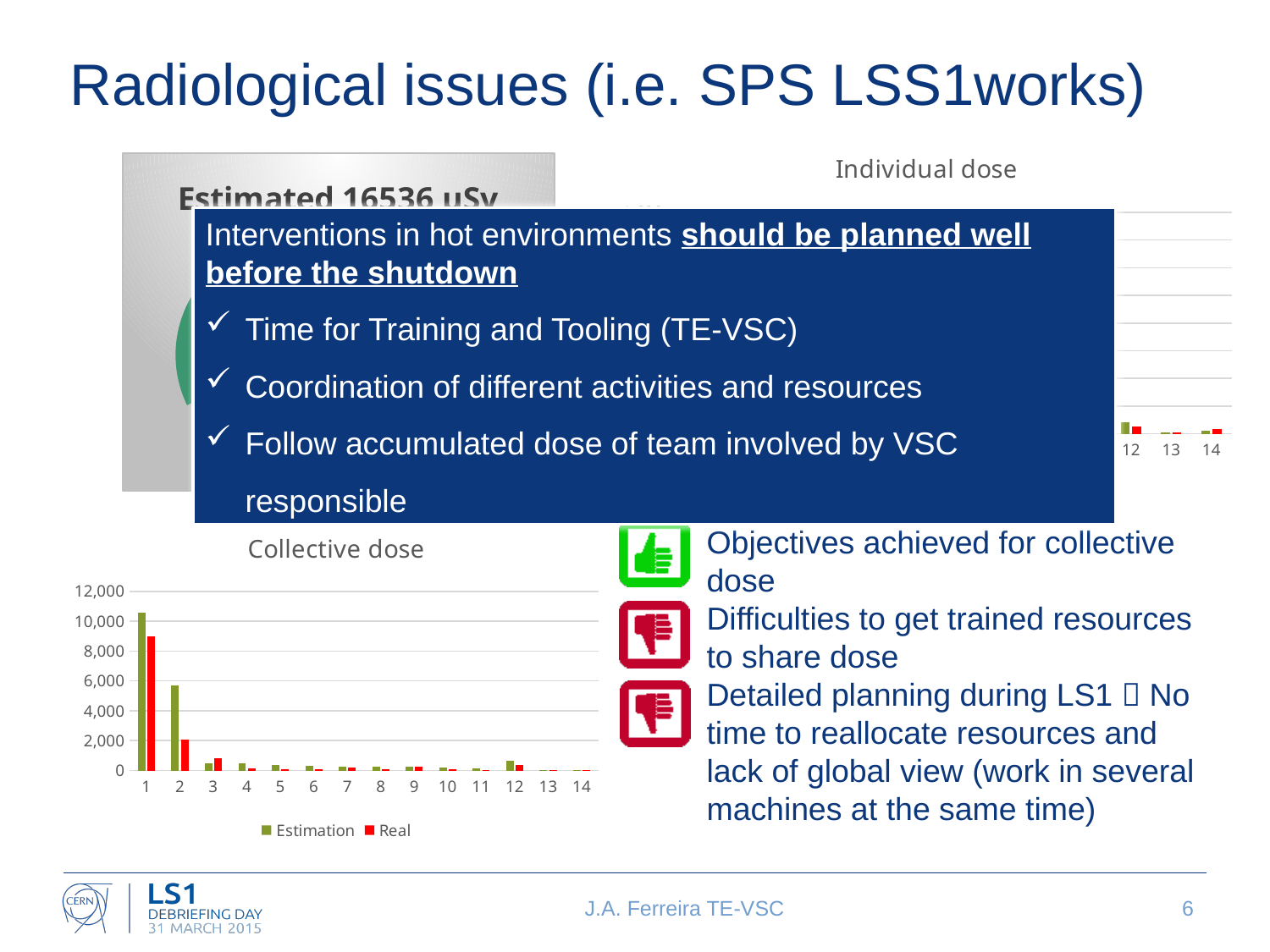
In the Collective dose chart, which category has the highest Estimation value? 1 What kind of chart is the Collective dose chart? bar chart In the Collective dose chart, which is larger for category 2, the Estimation value or the Real value? Estimation In the Collective dose chart, do the Estimation values generally rise or fall from category 1 to category 14? fall In the Collective dose chart, is the Estimation value for category 2 greater or less than 4,000? greater In the Collective dose chart, which category has the highest Real value? 1 In the Collective dose chart, is the Real value for category 1 greater or less than 8,000? greater In the Collective dose chart, is the Estimation value for category 1 greater or less than 10,000? greater How many series does the legend of the Collective dose chart list? 2 What are the two series named in the legend of the Collective dose chart? Estimation and Real In the Collective dose chart, which is larger for category 1, the Estimation value or the Real value? Estimation How many categories are shown on the x axis of the Collective dose chart? 14